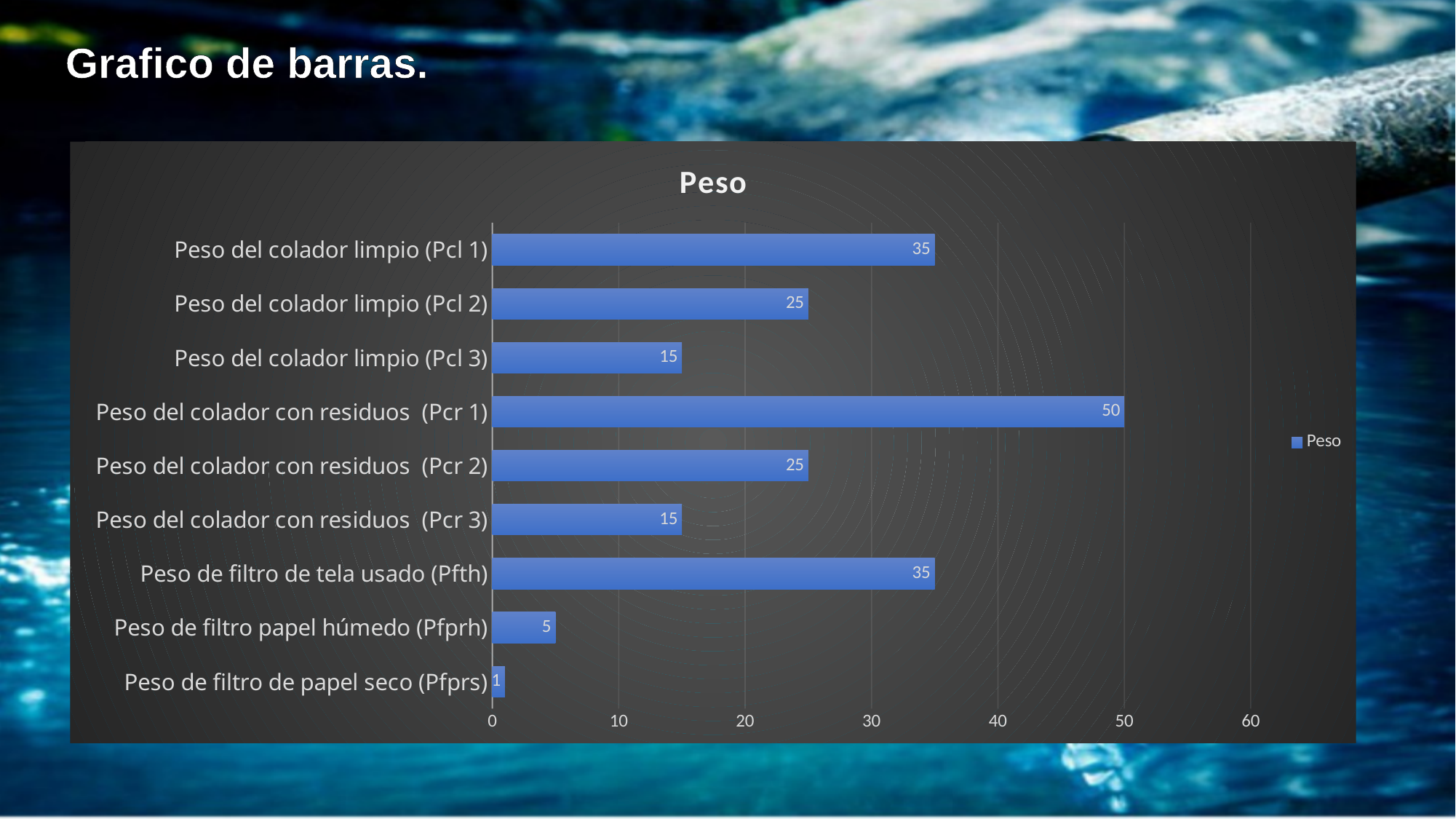
Is the value for Peso del colador con residuos (Pcr 2) greater or less than 30? less What is the value for Peso del colador limpio (Pcl 2)? 25 Which category has the highest value? Peso del colador con residuos (Pcr 1) Which category has the lowest value? Peso de filtro de papel seco (Pfprs) How many categories are shown in the chart? 9 What is the difference between Peso del colador con residuos (Pcr 1) and Peso del colador limpio (Pcl 1)? 15 What kind of chart is shown on the slide? bar chart What is the value for Peso del colador con residuos (Pcr 1)? 50 What is the value for Peso de filtro papel húmedo (Pfprh)? 5 What is the value for Peso de filtro de papel seco (Pfprs)? 1 What is the title of the chart? Peso Which is larger, Peso del colador limpio (Pcl 3) or Peso de filtro de tela usado (Pfth)? Peso de filtro de tela usado (Pfth)